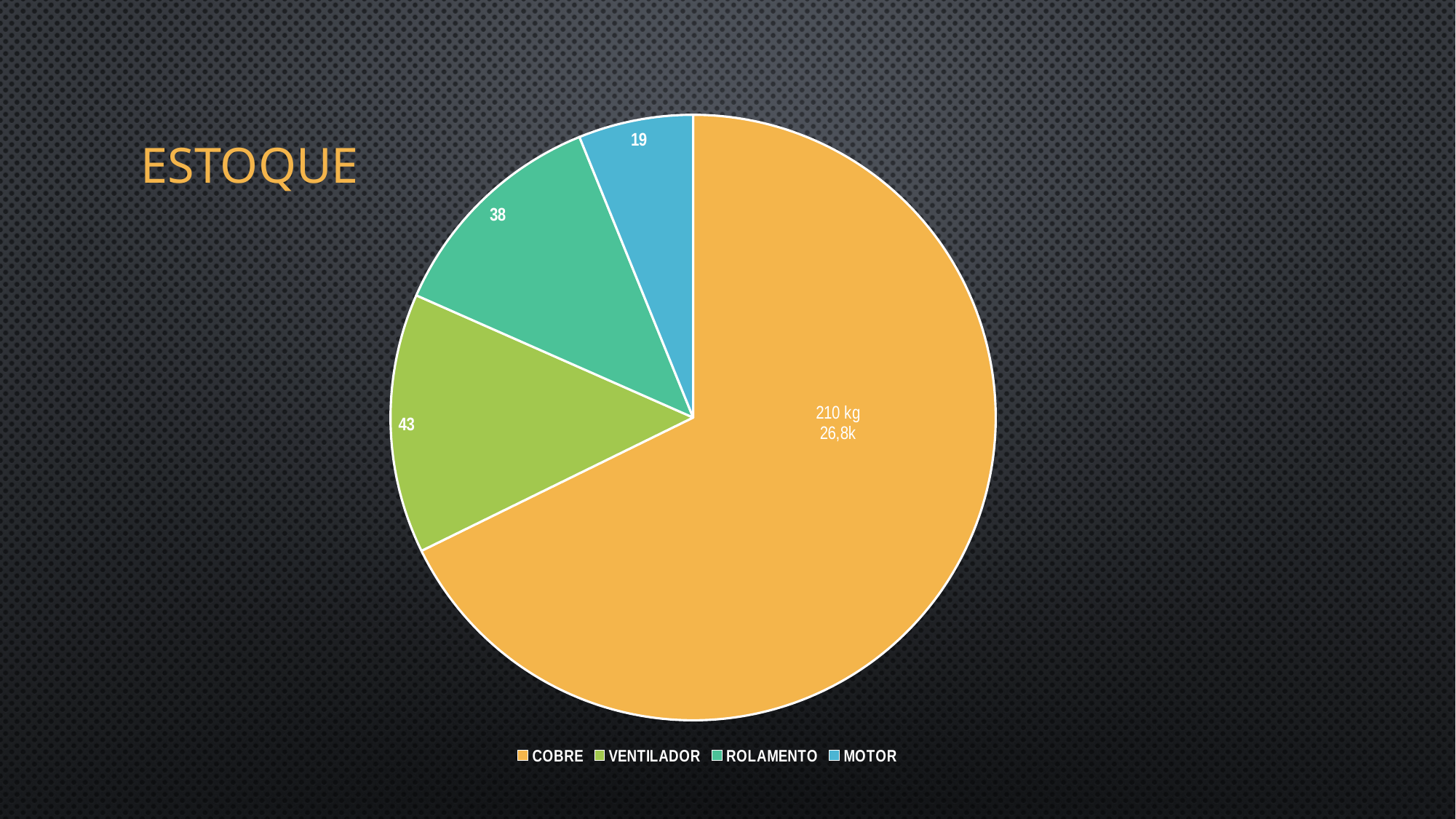
How many slices does the pie chart have? 4 Which is larger, the value for ROLAMENTO or the value for MOTOR? ROLAMENTO How many entries does the legend list? 4 What is the value shown for MOTOR? 19 What is the value shown for VENTILADOR? 43 What label is printed on the COBRE slice? 210 kg 26,8k What is the value shown for ROLAMENTO? 38 Which category has the largest slice of the pie? COBRE What is the difference between the values for VENTILADOR and ROLAMENTO? 5 Which category has the smallest slice of the pie? MOTOR What is the title of the slide? ESTOQUE What kind of chart is shown on the slide? pie chart